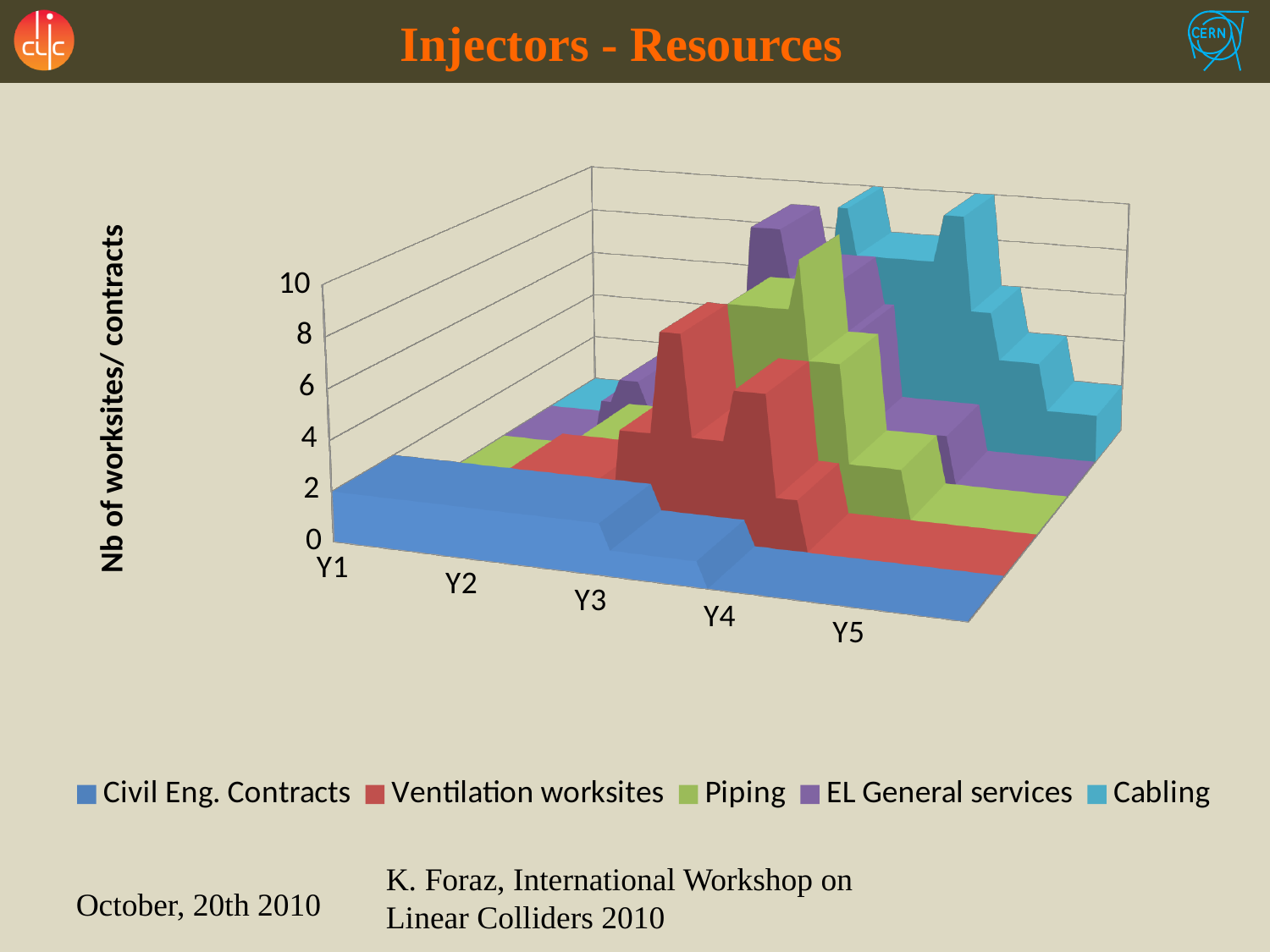
How many categories are shown along the x axis? 5 What kind of chart is shown on the slide? area chart How many series does the legend list? 5 What is the title of the slide containing the chart? Injectors - Resources What is the label of the vertical axis? Nb of worksites/ contracts Is the value for Civil Eng. Contracts at Y1 greater or less than 4? less